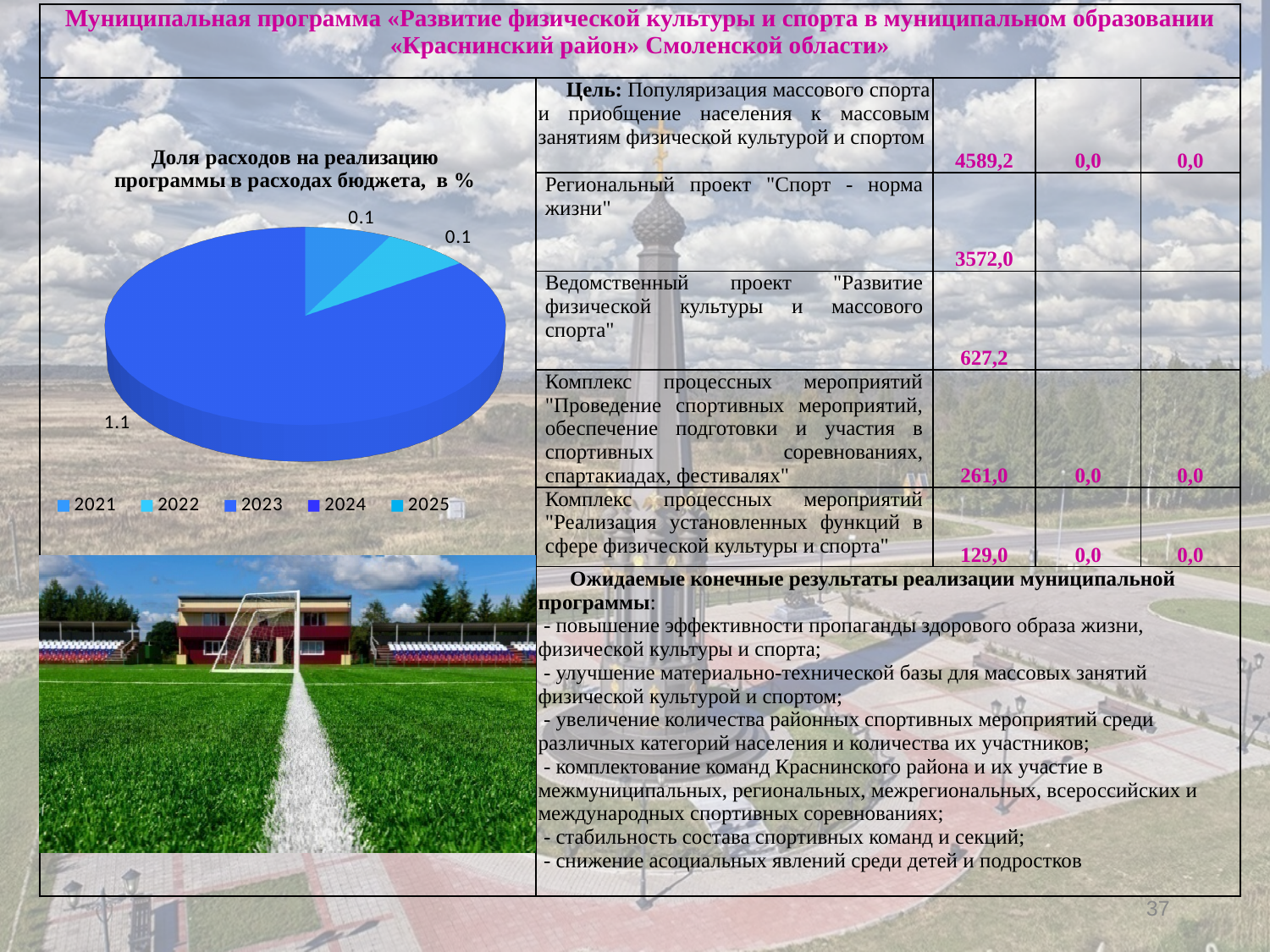
What is the smallest value labelled on the pie chart? 0.1 Is the largest slice of the pie chart larger or smaller than the two small slices combined? larger What is the difference between the largest labelled value (1.1) and a smallest labelled value (0.1) on the pie chart? 1.0 How many entries does the legend of the pie chart list? 5 How many data labels are shown on the pie chart? 3 What is the title of the pie chart? Доля расходов на реализацию программы в расходах бюджета, в % What is the largest value labelled on the pie chart? 1.1 What kind of chart is shown on the slide? pie chart Which years are listed in the legend of the pie chart? 2021, 2022, 2023, 2024, 2025 Is the largest labelled value on the pie chart greater or less than 1? greater